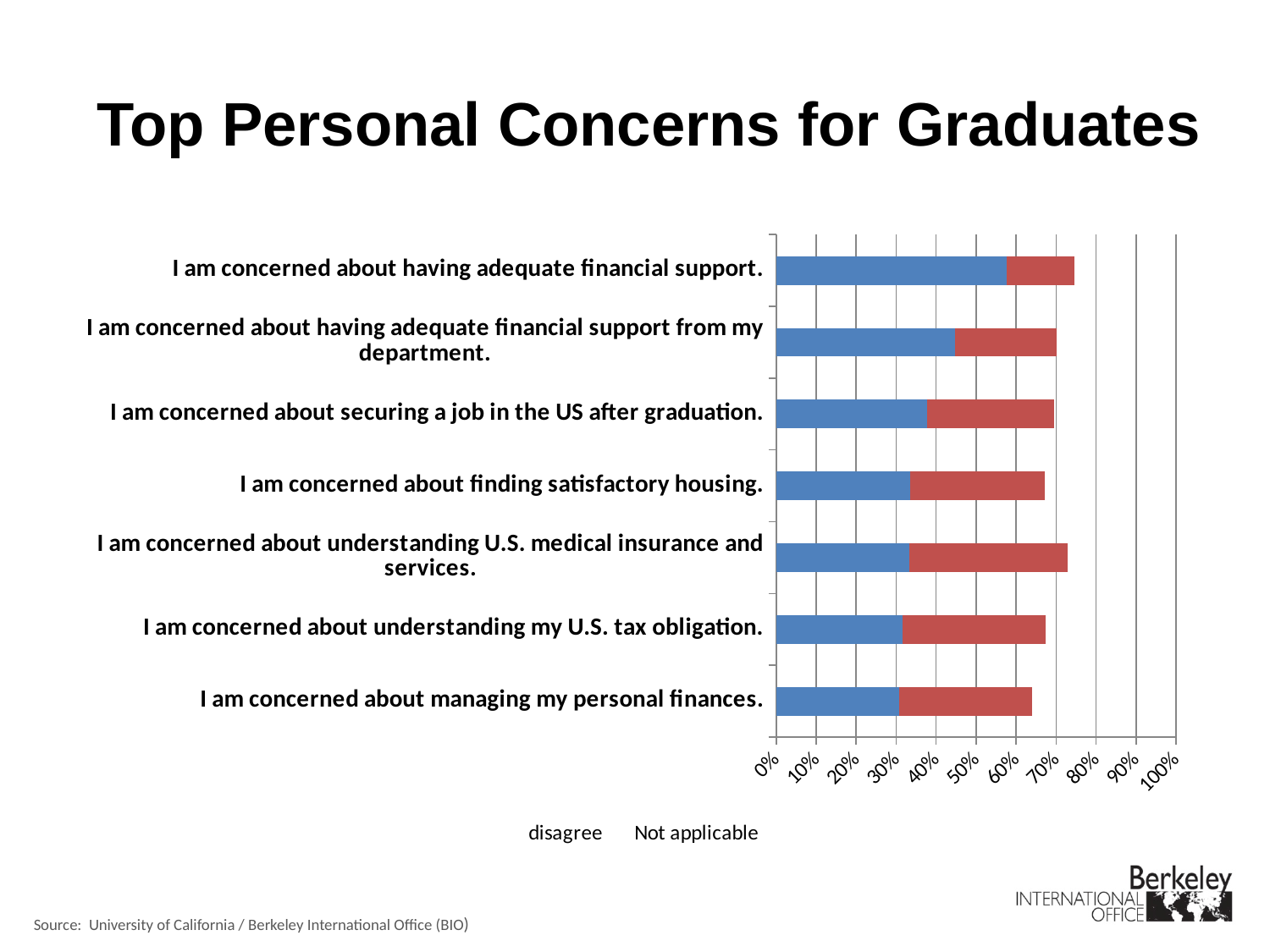
How many series does the chart legend list? 2 Is the total bar length for 'I am concerned about having adequate financial support.' greater or less than 70%? greater What is the title of the slide containing the chart? Top Personal Concerns for Graduates Which has the longer total bar: 'I am concerned about having adequate financial support.' or 'I am concerned about managing my personal finances.'? I am concerned about having adequate financial support. Is the total bar length for 'I am concerned about managing my personal finances.' greater or less than 70%? less How many concern statements (categories) are plotted on the chart? 7 What kind of chart is shown on the slide? Stacked bar chart What are the two series named in the legend? disagree; Not applicable